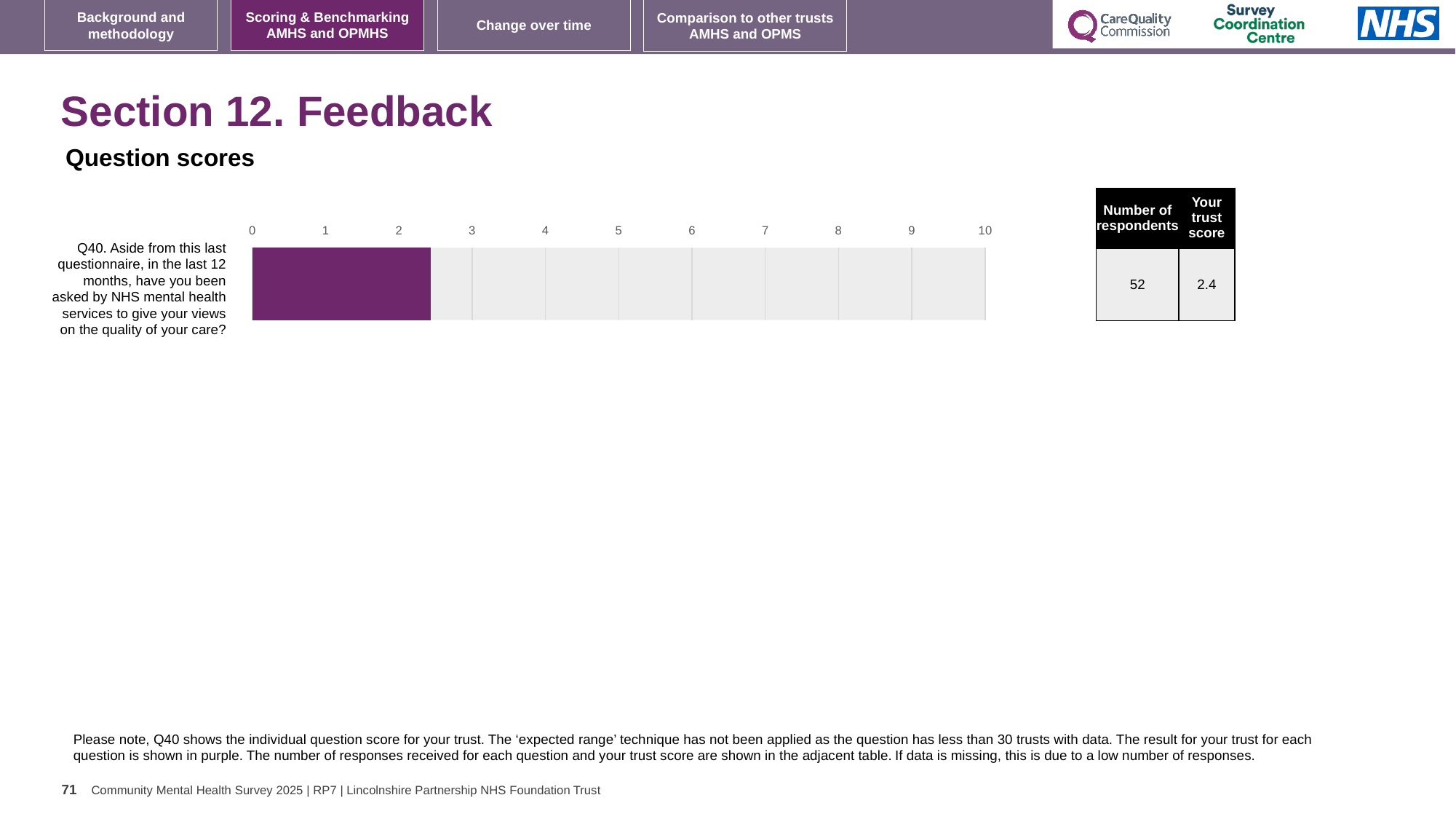
How many respondents answered Q40 according to the table? 52 Is the bar for Q40 greater or less than 5 on the axis? less What colour is the bar showing the trust's result for Q40? purple What kind of chart is used to show the Q40 question score? bar chart What is the trust score for Q40 shown in the table next to the chart? 2.4 Is the bar for Q40 greater or less than 3 on the axis? less Is the bar for Q40 greater or less than 2 on the axis? greater What is the maximum value shown on the chart's axis? 10 How many questions (categories) are plotted on the chart? 1